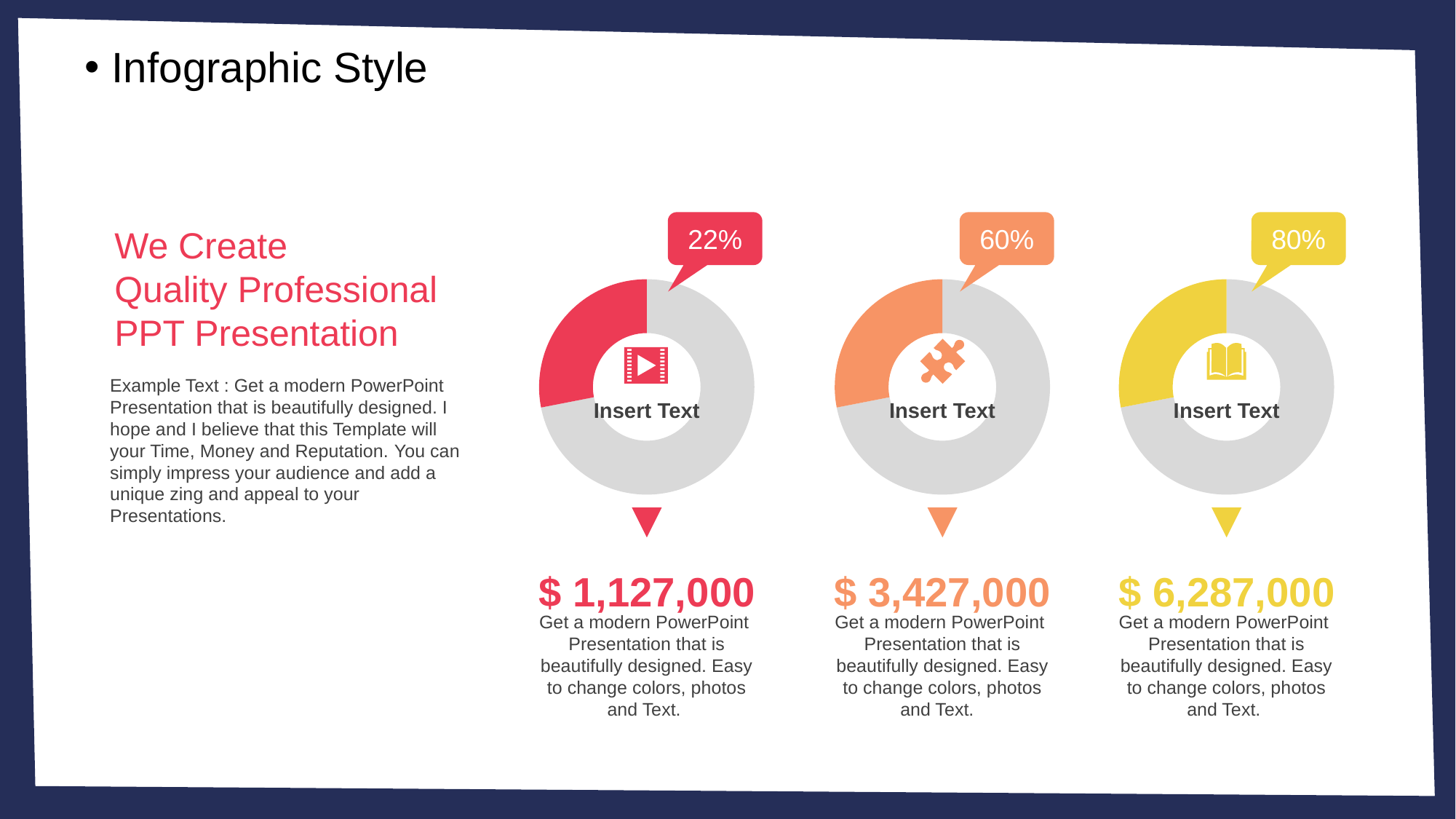
What percentage is shown in the callout above the left (red) donut chart? 22% What kind of chart is shown three times on the slide? donut chart How many donut charts are on the slide? 3 What dollar value is printed below the right (yellow) donut chart? $ 6,287,000 What dollar value is printed below the left (red) donut chart? $ 1,127,000 Which is larger, the percentage on the middle donut chart or the percentage on the left donut chart? the middle chart (60%) What is the difference between the percentage on the right donut chart and the percentage on the left donut chart? 58% Which donut chart shows the highest percentage? the right (yellow) chart, 80% What dollar value is printed below the middle (orange) donut chart? $ 3,427,000 Which donut chart shows the lowest percentage? the left (red) chart, 22% What percentage is shown in the callout above the right (yellow) donut chart? 80% What percentage is shown in the callout above the middle (orange) donut chart? 60%